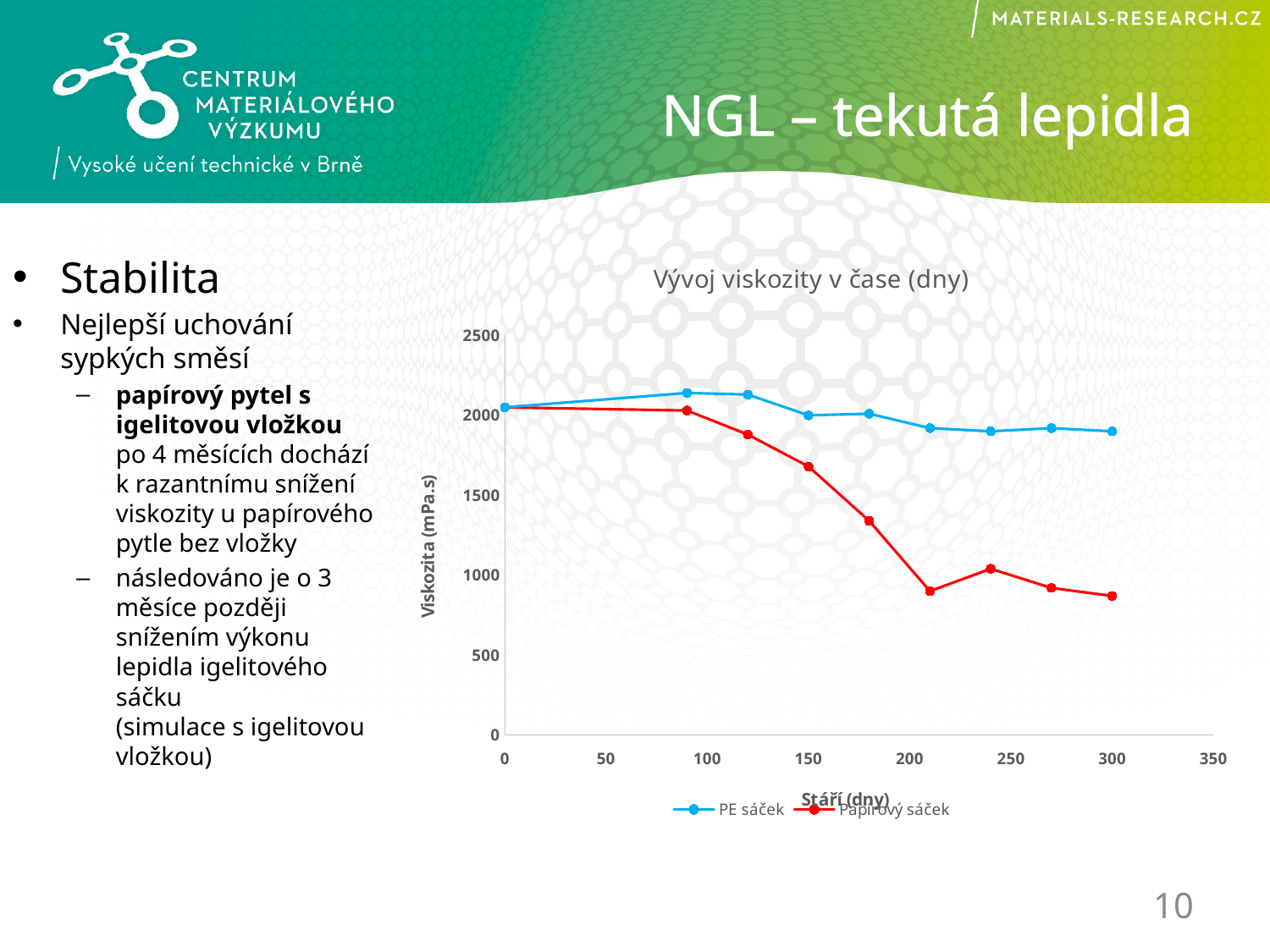
Is the value for Papírový sáček at 210 days greater or less than 1000? less What is the label of the vertical axis of the chart? Viskozita (mPa.s) Is the value for PE sáček at 90 days greater or less than 2000? greater At 300 days, which series has the higher viscosity, PE sáček or Papírový sáček? PE sáček How many series does the chart legend list? 2 What is the title of the chart? Vývoj viskozity v čase (dny) Is the value for PE sáček at 300 days greater or less than 1500? greater Does the viscosity of Papírový sáček rise or fall as the age in days increases? fall How many data points are plotted for the Papírový sáček series? 9 What kind of chart is shown on the slide? line chart